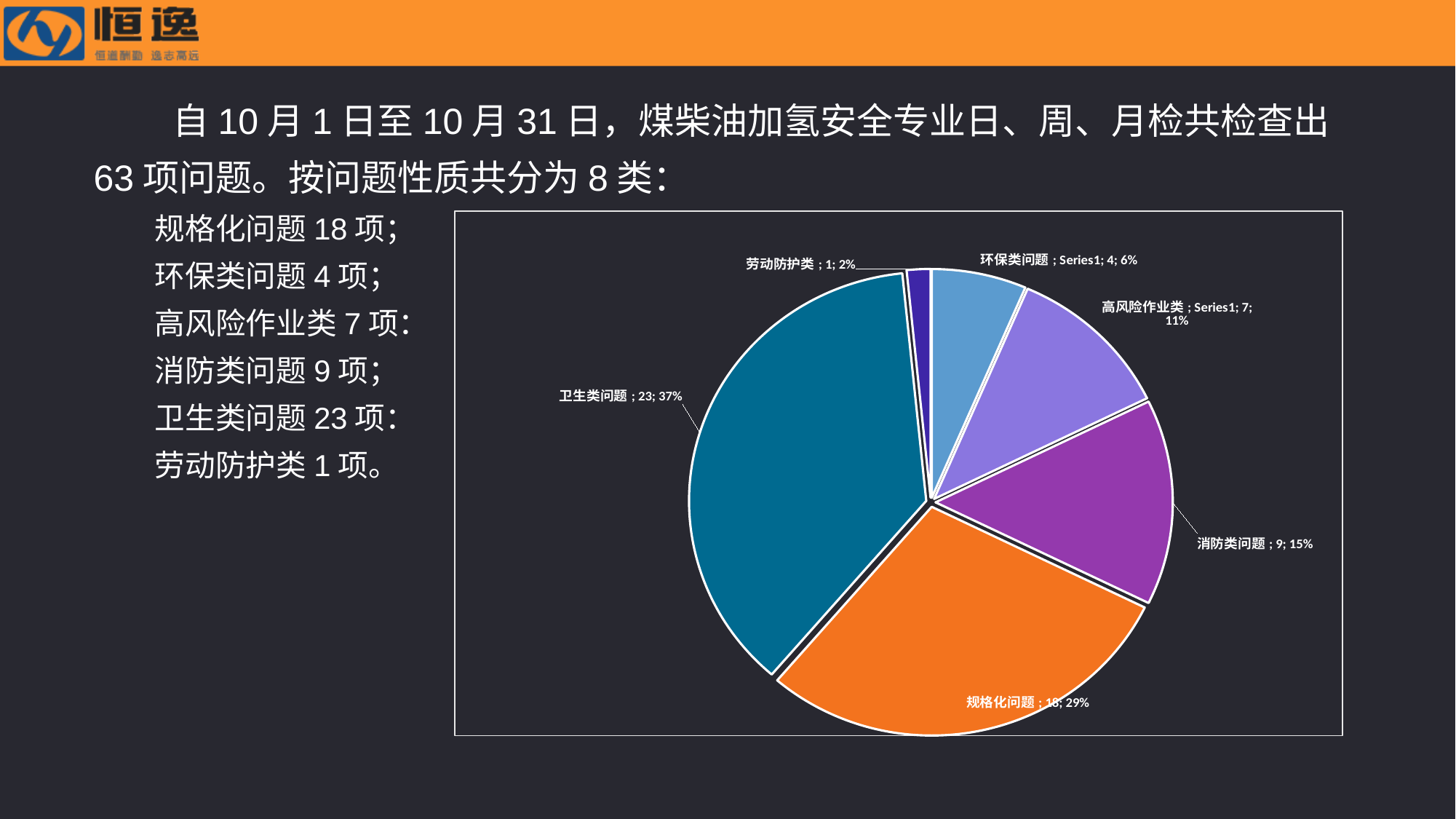
What percentage share does 环保类问题 have in the pie chart? 6% What is the difference between the values for 卫生类问题 and 规格化问题? 5 What percentage share does 劳动防护类 have in the pie chart? 2% What is the value shown for 规格化问题 in the pie chart? 18 Which category has the largest slice in the pie chart? 卫生类问题 Which category has the smallest slice in the pie chart? 劳动防护类 What is the value shown for 消防类问题 in the pie chart? 9 How many slices does the pie chart have? 6 What is the value shown for 卫生类问题 in the pie chart? 23 What kind of chart is shown on the slide? pie chart What is the value shown for 高风险作业类 in the pie chart? 7 Which is larger in the pie chart, 消防类问题 or 高风险作业类? 消防类问题